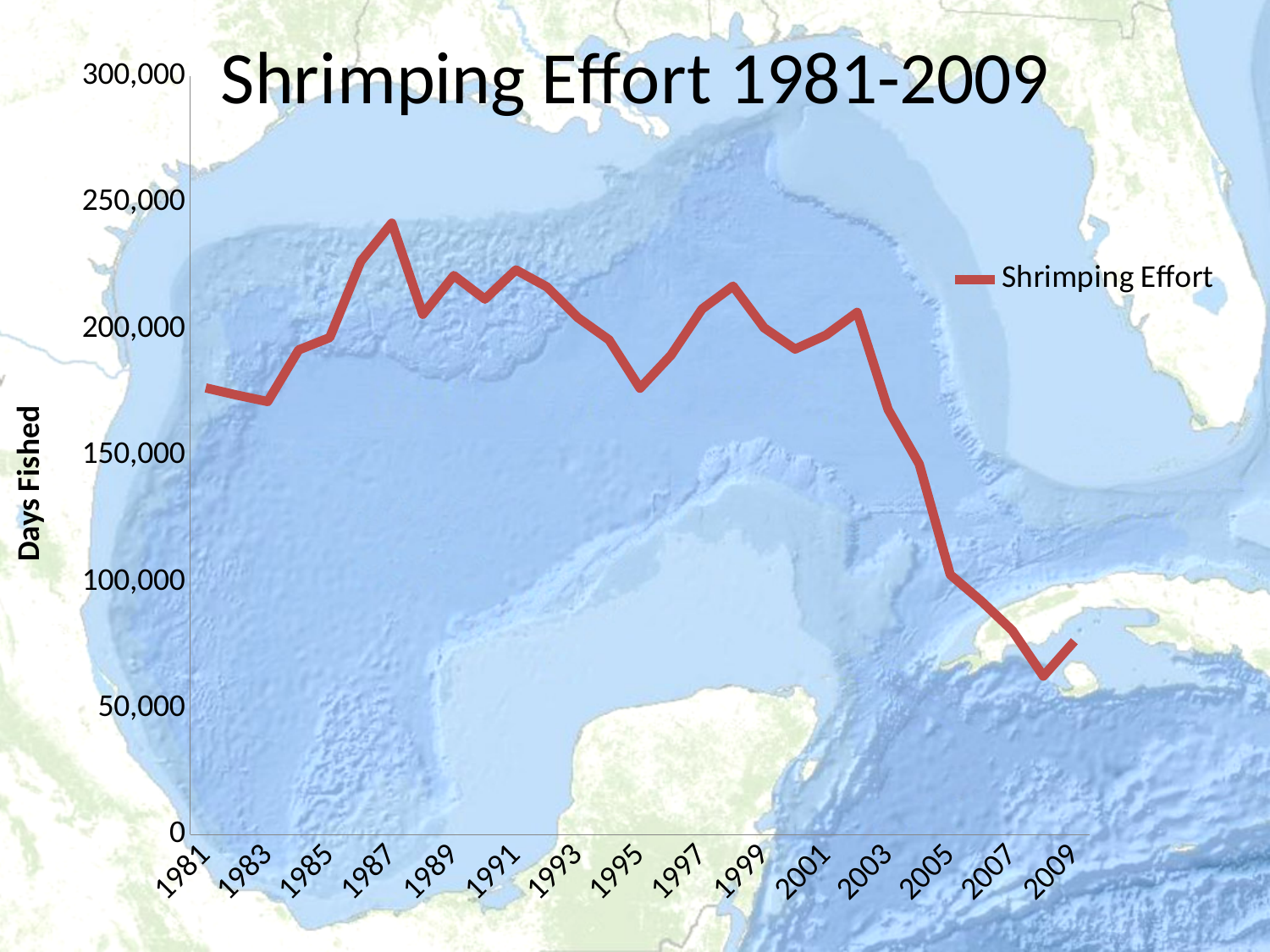
Is the value for 1987 greater or less than 200,000? greater How many series does the legend list? 1 What is the label on the vertical axis? Days Fished What kind of chart is shown on the slide? Line chart Is the value for 1981 greater or less than 150,000? greater Does the shrimping effort rise or fall between 2003 and 2008? Fall Which year has the larger shrimping effort, 1983 or 1985? 1985 Which year has the larger shrimping effort, 1987 or 2009? 1987 In which year is the shrimping effort highest? 1987 Is the value for 2008 greater or less than 100,000? less What is the title of the chart? Shrimping Effort 1981-2009 In which year is the shrimping effort lowest? 2008